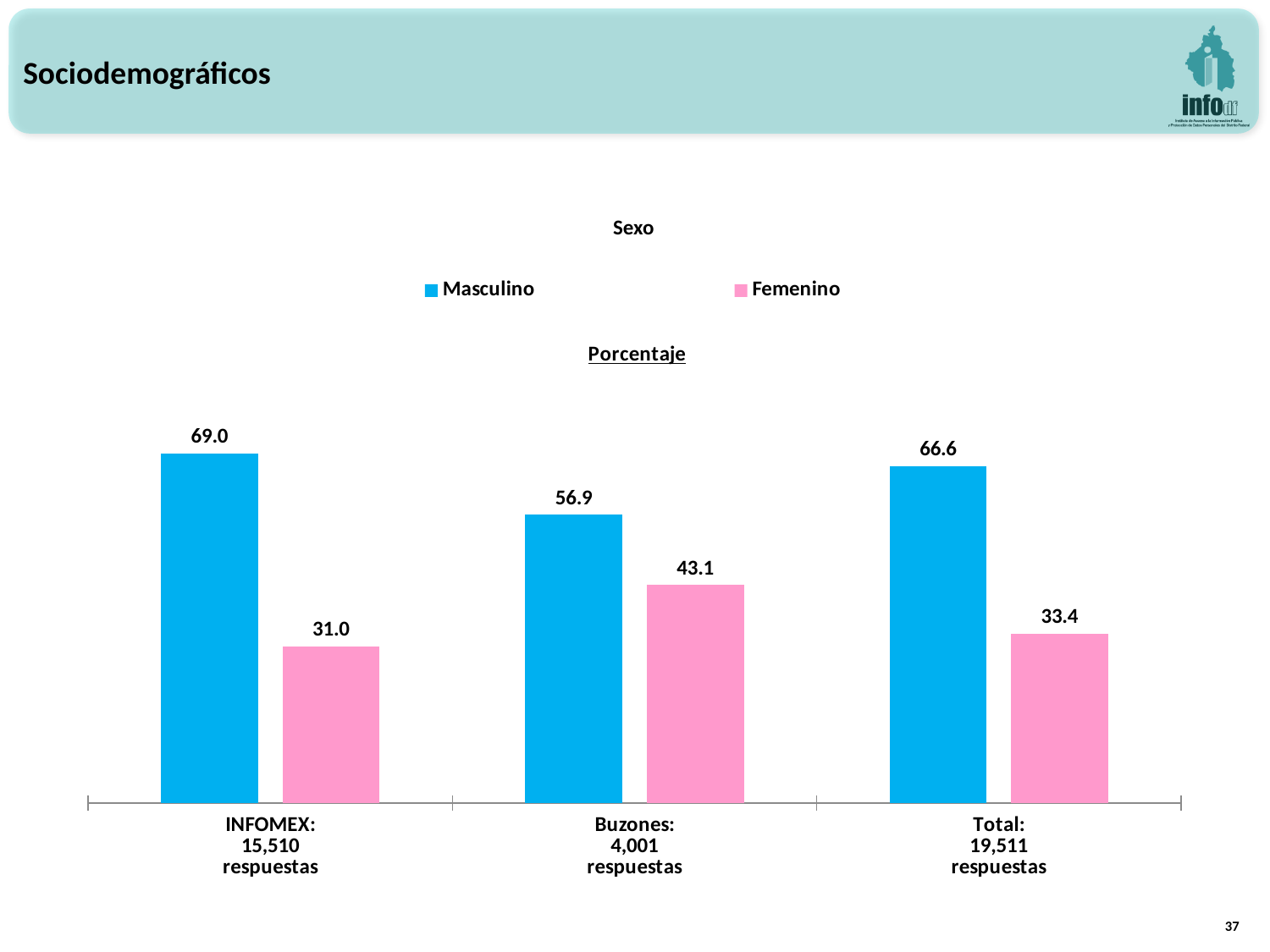
How many series does the legend list? 2 Which category has the lowest Femenino value? INFOMEX How many categories are shown on the x axis? 3 Which is larger for Total: the Masculino value or the Femenino value? Masculino What is the Femenino value for Total? 33.4 What is the difference between the Masculino and Femenino values for Buzones? 13.8 What is the Masculino value for INFOMEX? 69.0 What kind of chart is shown on the slide? Bar chart What is the Femenino value for Buzones? 43.1 Which category has the highest Masculino value? INFOMEX What is the title of the chart? Porcentaje Which colour represents the Femenino series? Pink